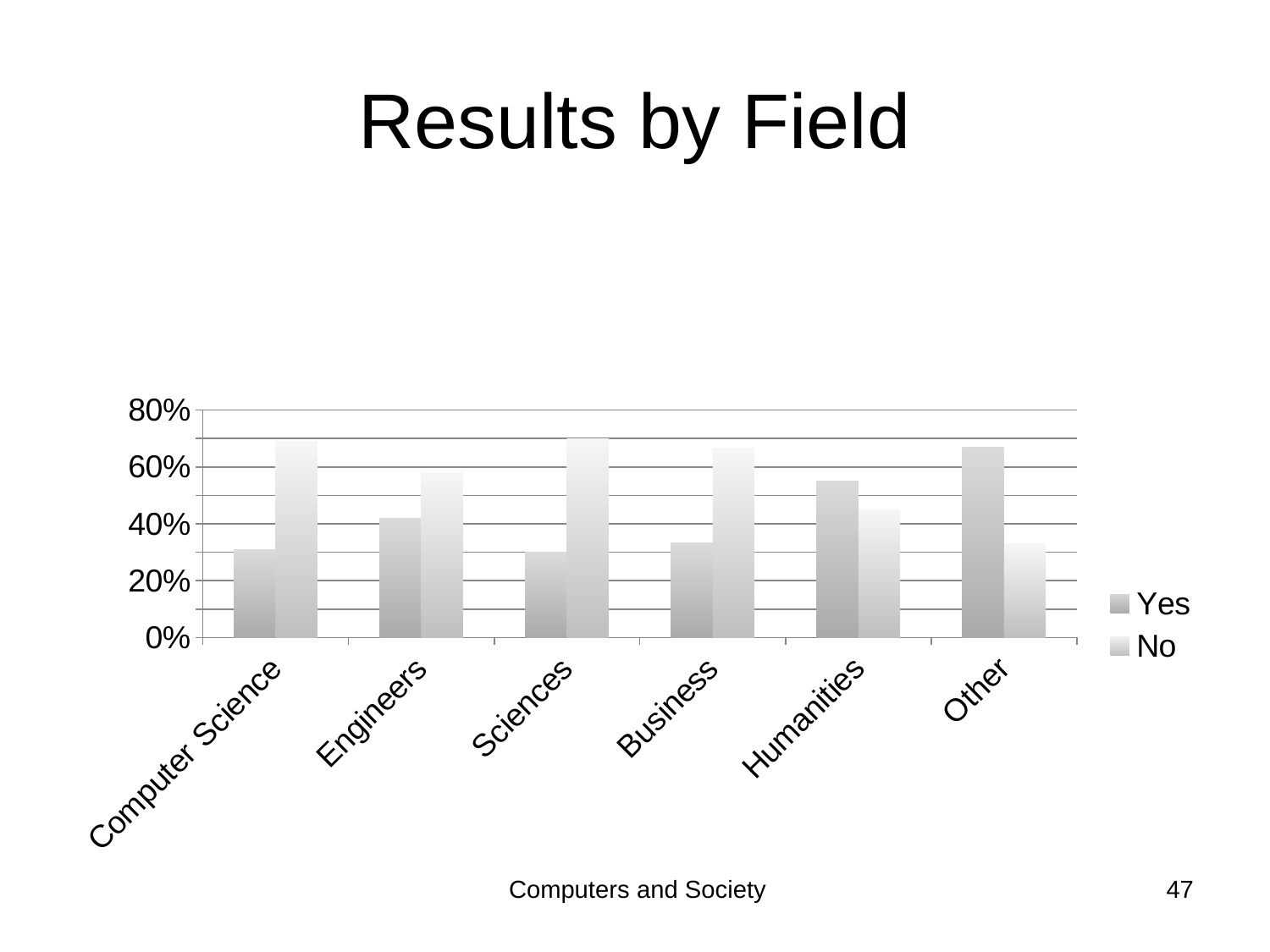
What are the two series named in the legend? Yes and No Is the Yes value for Business greater or less than 40%? less Is the Yes value for Humanities greater or less than 40%? greater How many fields (categories) are shown on the x axis of the chart? 6 For Humanities, which is larger, the Yes value or the No value? Yes What kind of chart is shown on the slide? bar chart What is the title of the chart on the slide? Results by Field How many series does the chart's legend list? 2 Is the No value for Computer Science greater or less than 60%? greater For Engineers, which is larger, the Yes value or the No value? No Which field has the lowest No value? Other Which field has the highest Yes value? Other